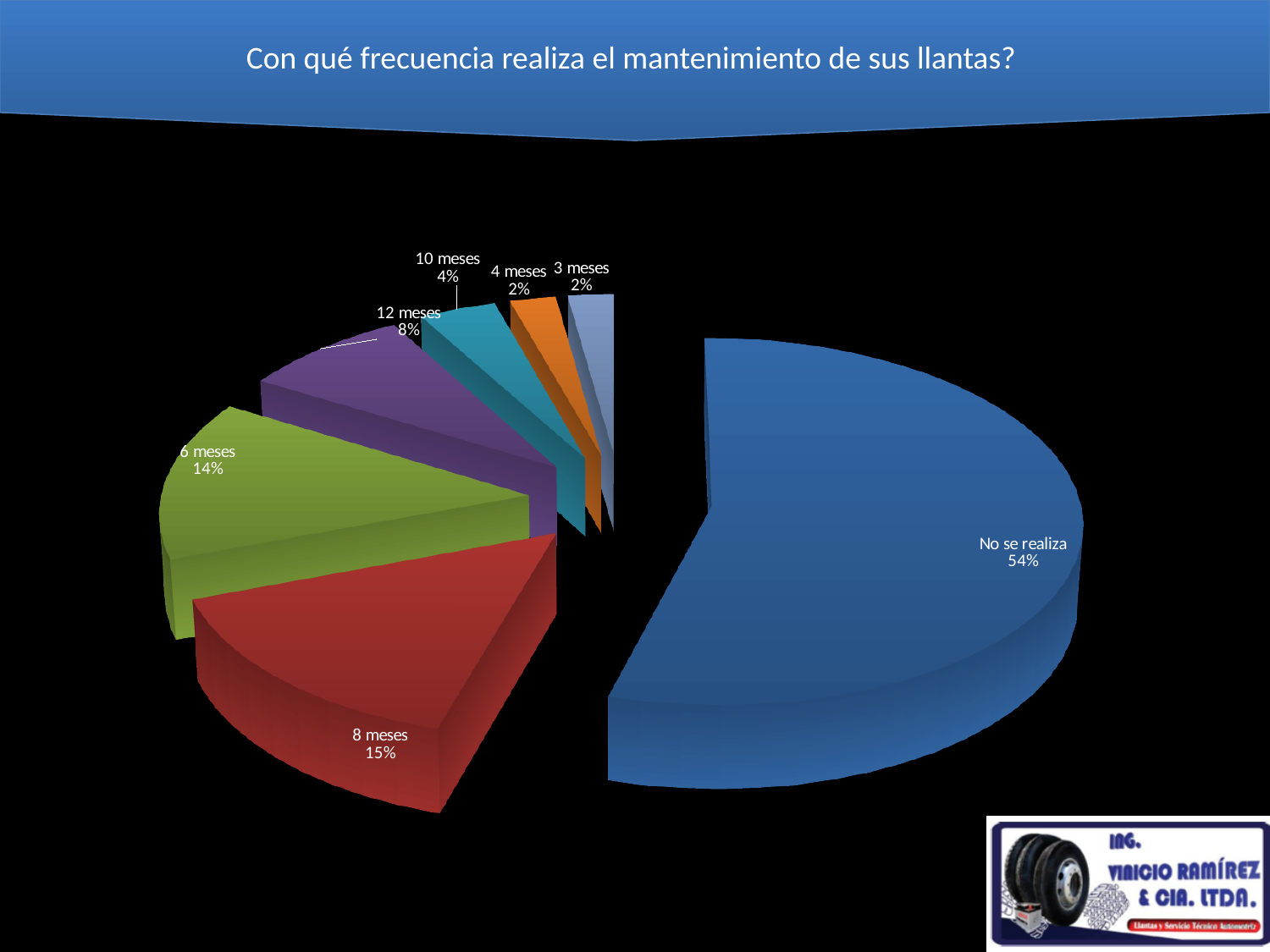
What share of the pie does "No se realiza" represent? 54% What is the value shown for "10 meses"? 4% What kind of chart is shown on the slide? Pie chart Which is larger, the share for "12 meses" or the share for "10 meses"? 12 meses Which category has the largest slice of the pie? No se realiza What is the difference between the shares for "No se realiza" and "8 meses"? 39% What is the value shown for "6 meses"? 14% What is the value shown for "8 meses"? 15% What is the title of the chart on the slide? Con qué frecuencia realiza el mantenimiento de sus llantas? What is the value shown for "12 meses"? 8% How many slices does the pie chart have? 7 What is the difference between the shares for "8 meses" and "6 meses"? 1%